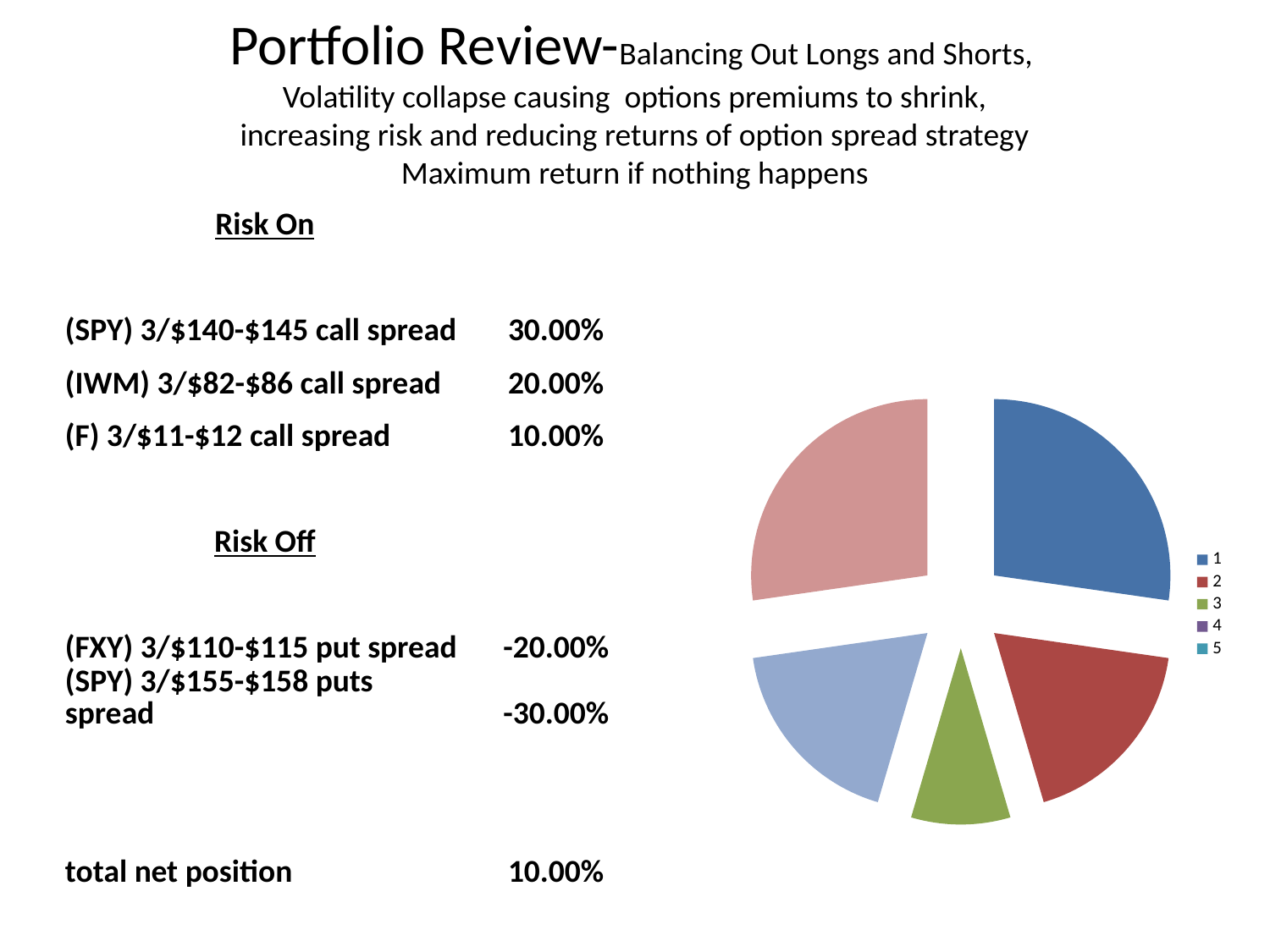
What are the legend entries of the pie chart? 1, 2, 3, 4, 5 How many entries does the legend of the pie chart list? 5 How many slices does the pie chart have? 5 Which is larger in the pie chart, slice 1 or slice 3? 1 Which is larger in the pie chart, slice 2 or slice 3? 2 What kind of chart is shown on the slide? pie chart Which slice of the pie chart is the smallest? 3 What colour is slice 3 in the pie chart? green